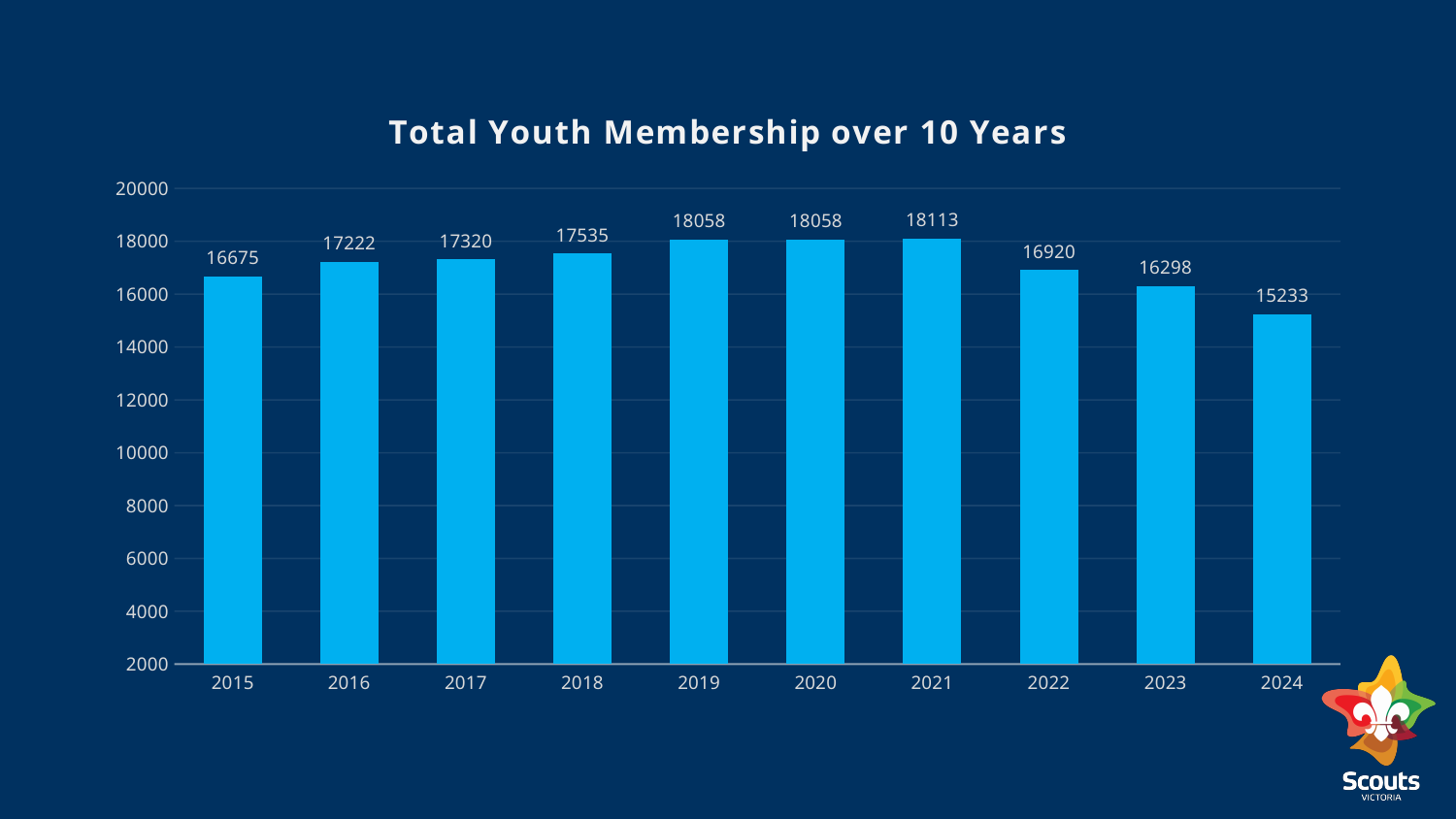
How many years are shown on the chart? 10 What kind of chart is shown on the slide? Bar chart What is the total youth membership for 2019? 18058 What is the difference in youth membership between 2021 and 2024? 2880 What is the title of the chart? Total Youth Membership over 10 Years Which year has the highest total youth membership? 2021 What is the difference in youth membership between 2016 and 2015? 547 What is the total youth membership for 2015? 16675 What is the total youth membership for 2024? 15233 Which year has the lowest total youth membership? 2024 Is the value for 2023 greater or less than 16000? greater Which year has a larger youth membership, 2018 or 2022? 2018